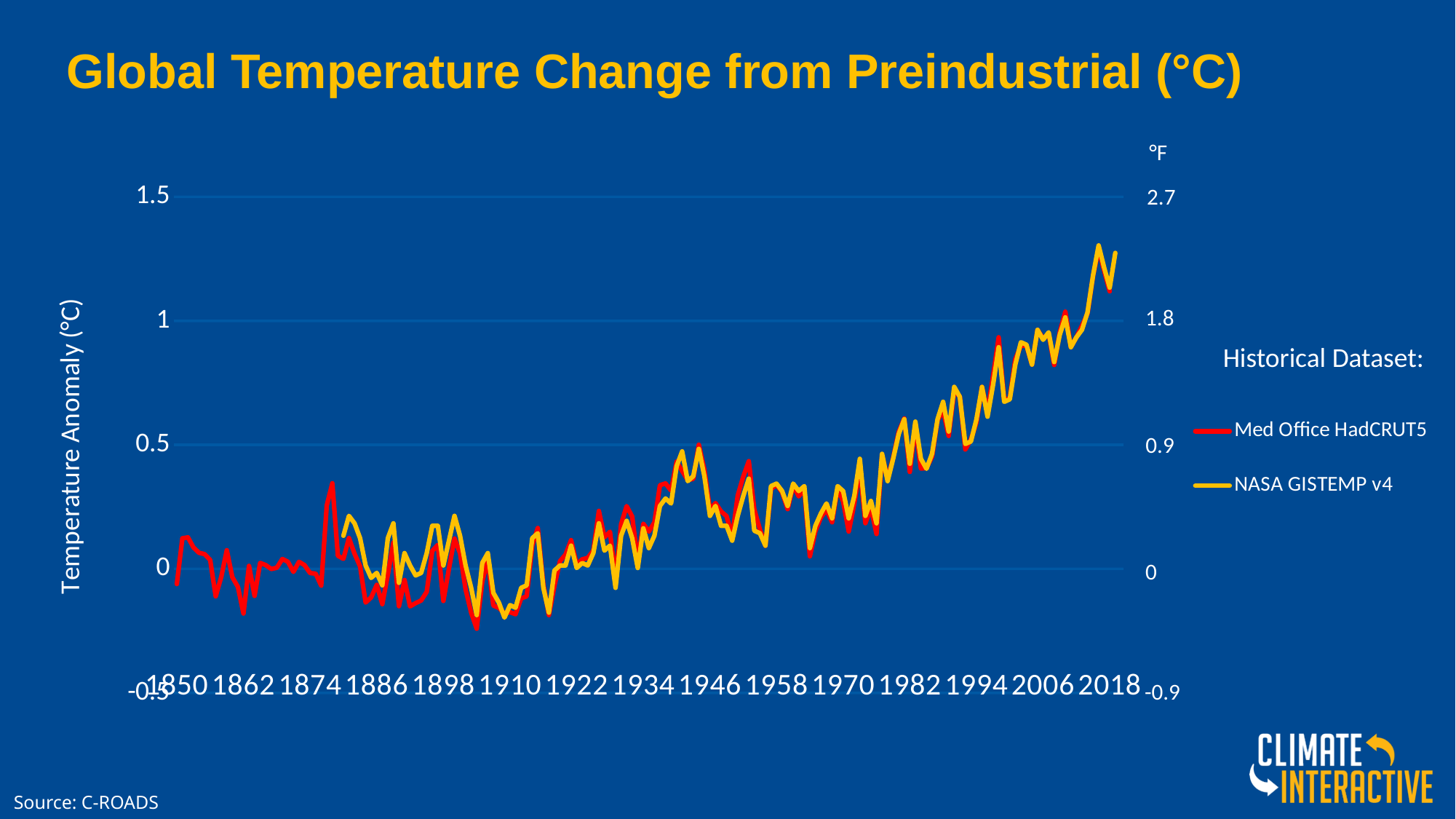
How many year labels are shown along the x axis? 15 Is the Med Office HadCRUT5 value at 1850 greater or less than 0.5? less Is the Med Office HadCRUT5 value at 1994 greater or less than 0.5? greater What kind of chart is shown on the slide? Line chart Do the temperature anomaly values generally rise or fall from 1850 to 2018? Rise How many series does the legend list? 2 Is the NASA GISTEMP v4 value at 1910 greater or less than 0? less Which two datasets are plotted according to the legend? Med Office HadCRUT5 and NASA GISTEMP v4 What is the title of the chart? Global Temperature Change from Preindustrial (°C)